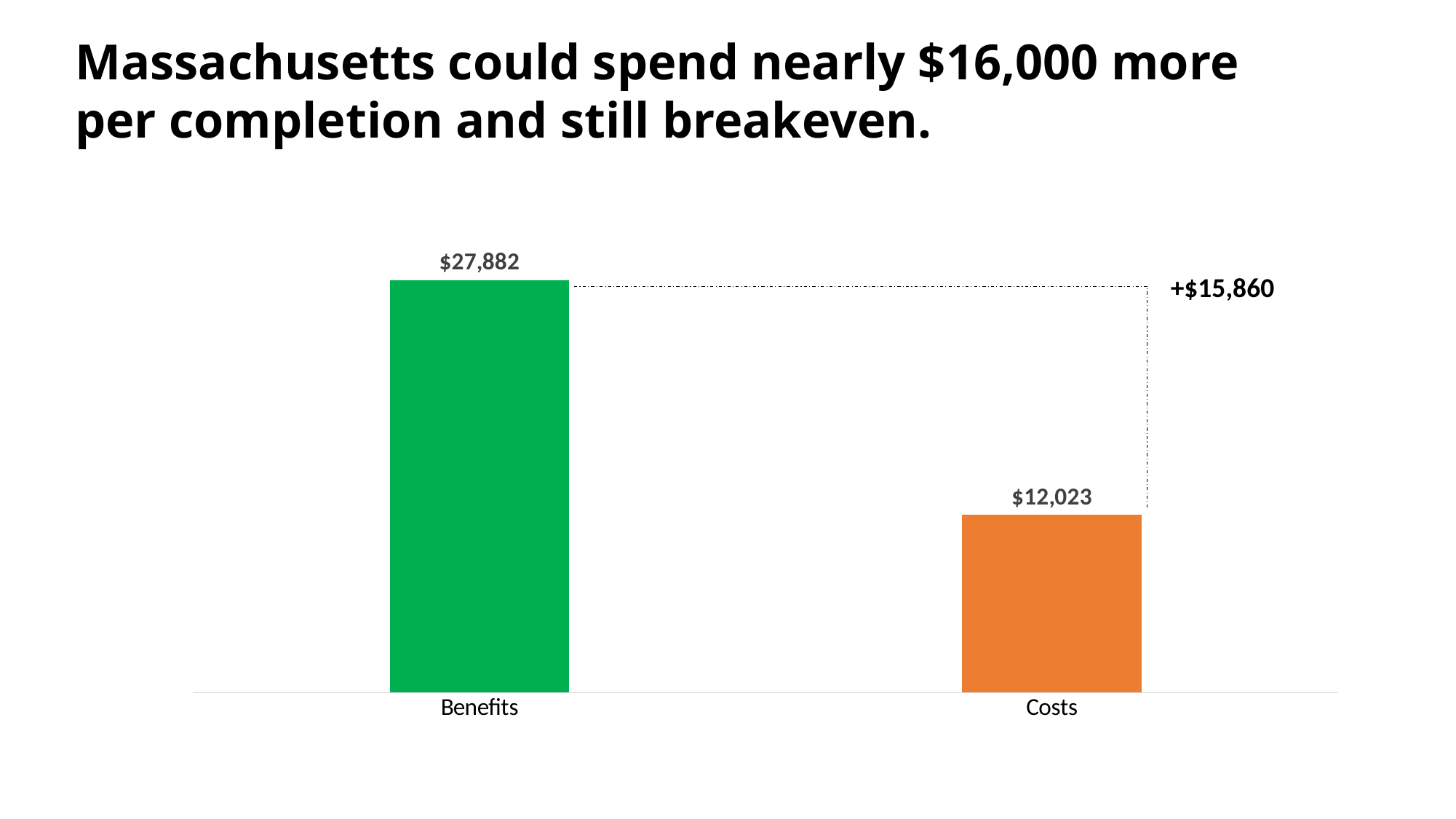
What colour is the Costs bar? orange What kind of chart is shown on the slide? bar chart What colour is the Benefits bar? green What is the value of the Costs bar? $12,023 Which category has the lower value? Costs What value is annotated next to the dashed line connecting the two bars? +$15,860 What is the value of the Benefits bar? $27,882 How many categories are shown on the chart? 2 Which category has the higher value? Benefits Is the value for Benefits larger or smaller than the value for Costs? larger What is the difference between Benefits and Costs? $15,860